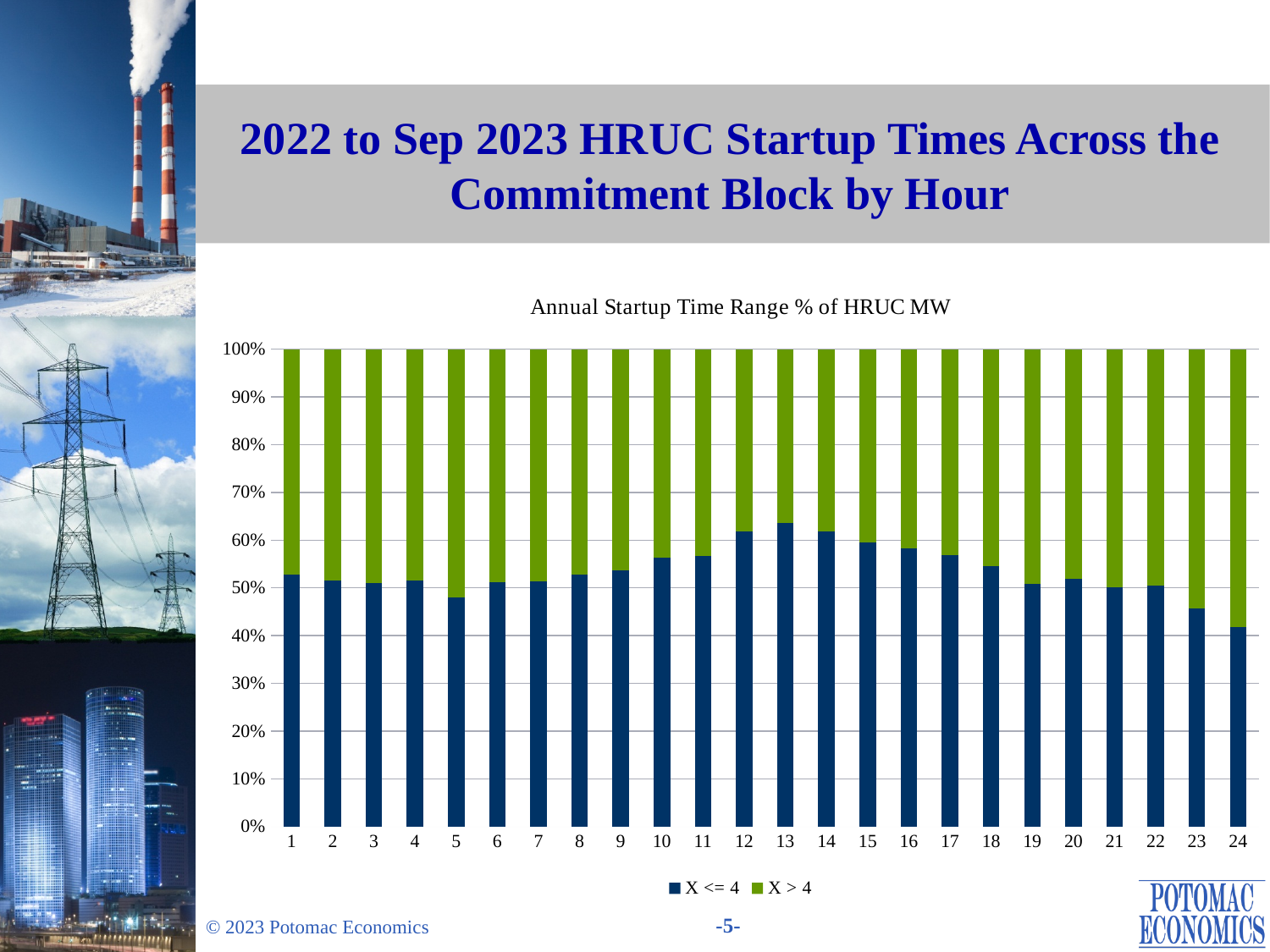
Which hour has the larger X <= 4 share, hour 13 or hour 3? Hour 13 What is the total height of the stacked bar for hour 1? 100% Which hour has the highest share for the X > 4 series? 24 How many hours (categories) are shown on the x axis of the chart? 24 Does the X <= 4 share rise or fall from hour 13 to hour 24? Fall Is the X <= 4 share for hour 24 greater or less than 50%? less Which hour has the lowest share for the X <= 4 series? 24 What kind of chart is shown on the slide? Stacked bar chart How many series does the chart legend list? 2 Is the X <= 4 share for hour 13 greater or less than 60%? greater What is the title printed above the chart? Annual Startup Time Range % of HRUC MW